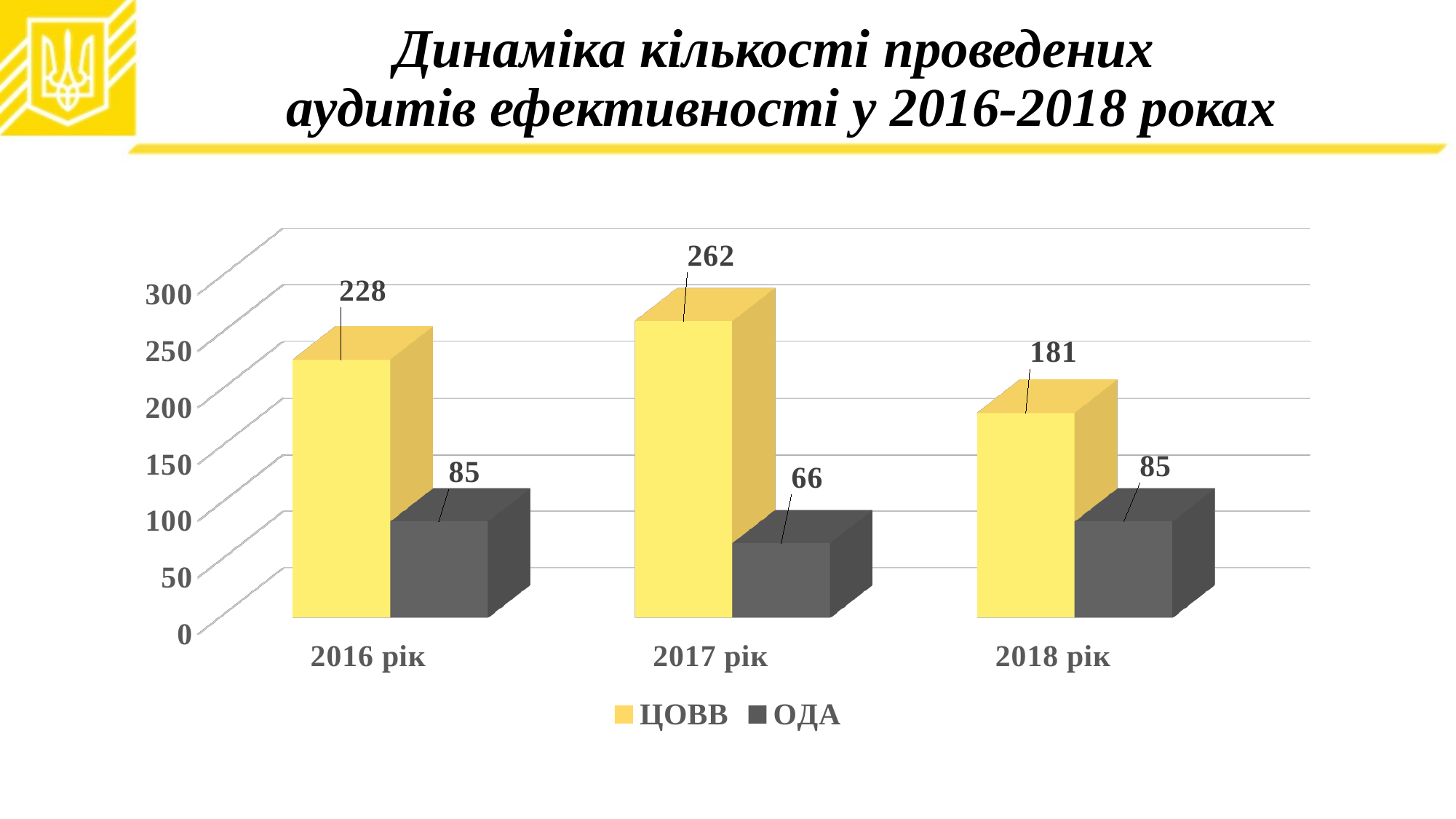
What is the value for ЦОВВ in 2018 рік? 181 How many series does the legend list? 2 What kind of chart is shown on the slide? Bar chart Which is larger in 2016 рік, the value for ЦОВВ or the value for ОДА? ЦОВВ What is the difference between the ЦОВВ values for 2017 рік and 2018 рік? 81 How many years are shown on the x axis? 3 Which year has the lowest value for ОДА? 2017 рік Which year has the highest value for ЦОВВ? 2017 рік What is the value for ОДА in 2017 рік? 66 Which colour represents the ОДА series? Dark grey What is the value for ЦОВВ in 2016 рік? 228 Does the ЦОВВ value rise or fall from 2017 рік to 2018 рік? Fall